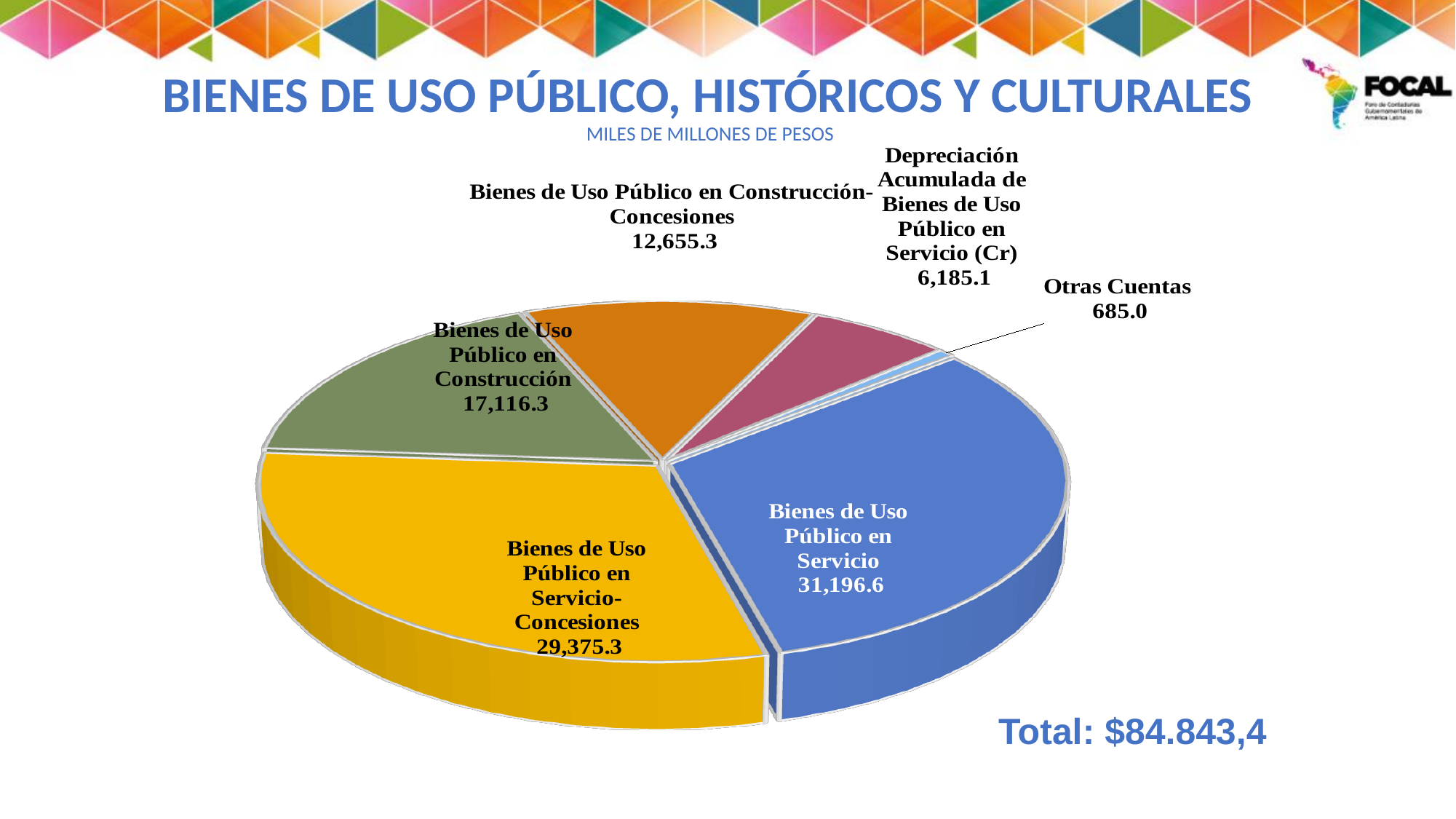
What type of chart is shown on the slide? Pie chart What is the value for Otras Cuentas? 685.0 What unit is stated in the subtitle below the chart title? MILES DE MILLONES DE PESOS What is the value for Depreciación Acumulada de Bienes de Uso Público en Servicio (Cr)? 6,185.1 Which category has the largest slice of the pie? Bienes de Uso Público en Servicio What is the difference between Bienes de Uso Público en Servicio and Bienes de Uso Público en Servicio-Concesiones? 1,821.3 Which category has the smallest slice of the pie? Otras Cuentas What is the value for Bienes de Uso Público en Construcción? 17,116.3 What is the value for Bienes de Uso Público en Servicio-Concesiones? 29,375.3 How many slices does the pie chart have? 6 Which is larger: Bienes de Uso Público en Construcción or Bienes de Uso Público en Construcción-Concesiones? Bienes de Uso Público en Construcción What is the value for Bienes de Uso Público en Servicio? 31,196.6